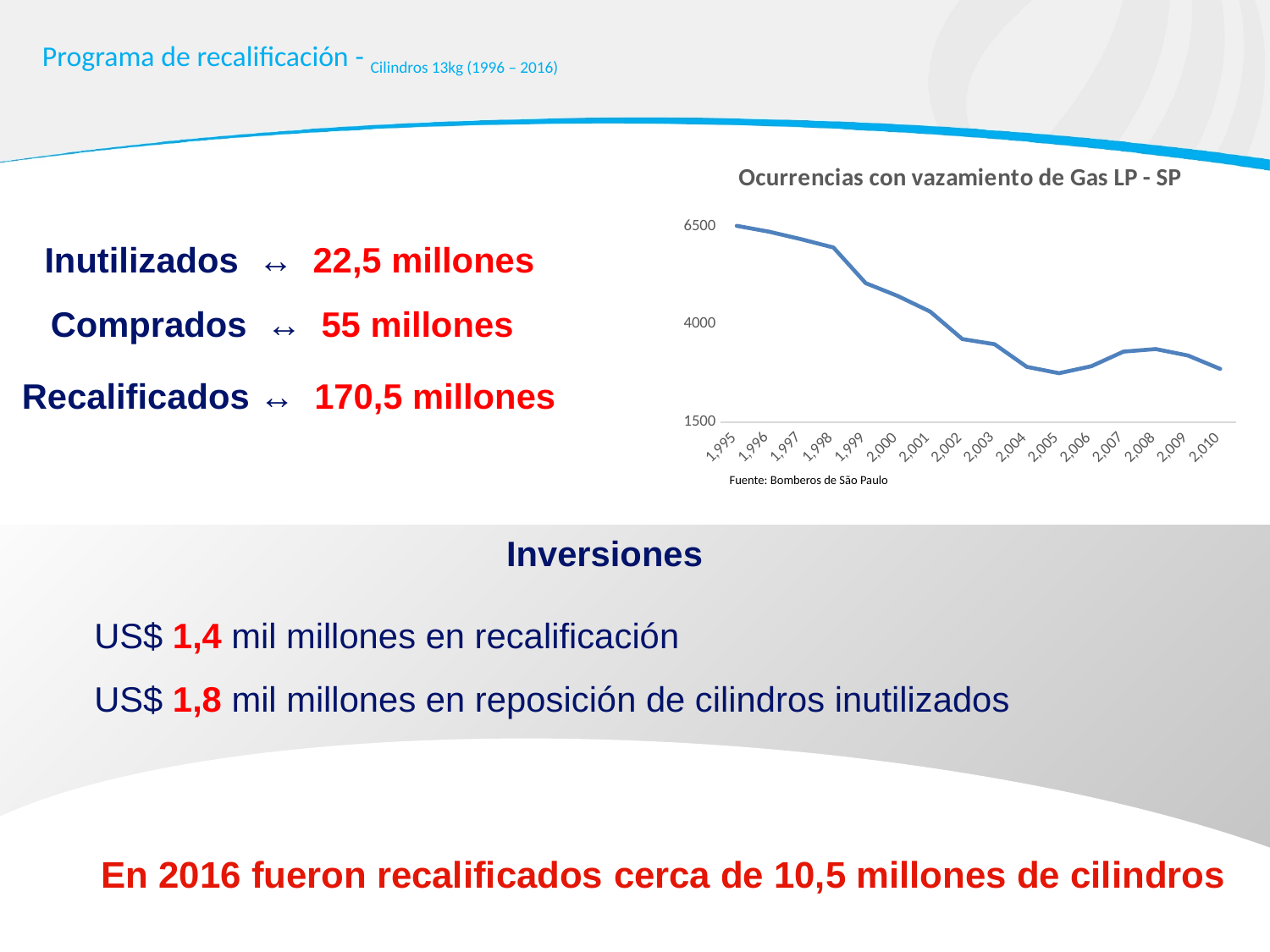
What kind of chart is shown on the slide? line chart What source is cited below the chart? Bomberos de São Paulo Is the value for 2010 greater or less than 4000? less Do the values in the chart generally rise or fall from 1995 to 2010? fall Is the value for 1995 greater or less than 4000? greater What is the title of the chart on the slide? Ocurrencias con vazamiento de Gas LP - SP Is the value for 2005 greater or less than 4000? less Which year has the larger value, 1998 or 2004? 1998 How many years are plotted along the x axis of the chart? 16 Which year has the highest value in the chart? 1995 Which year has the larger value, 1995 or 2010? 1995